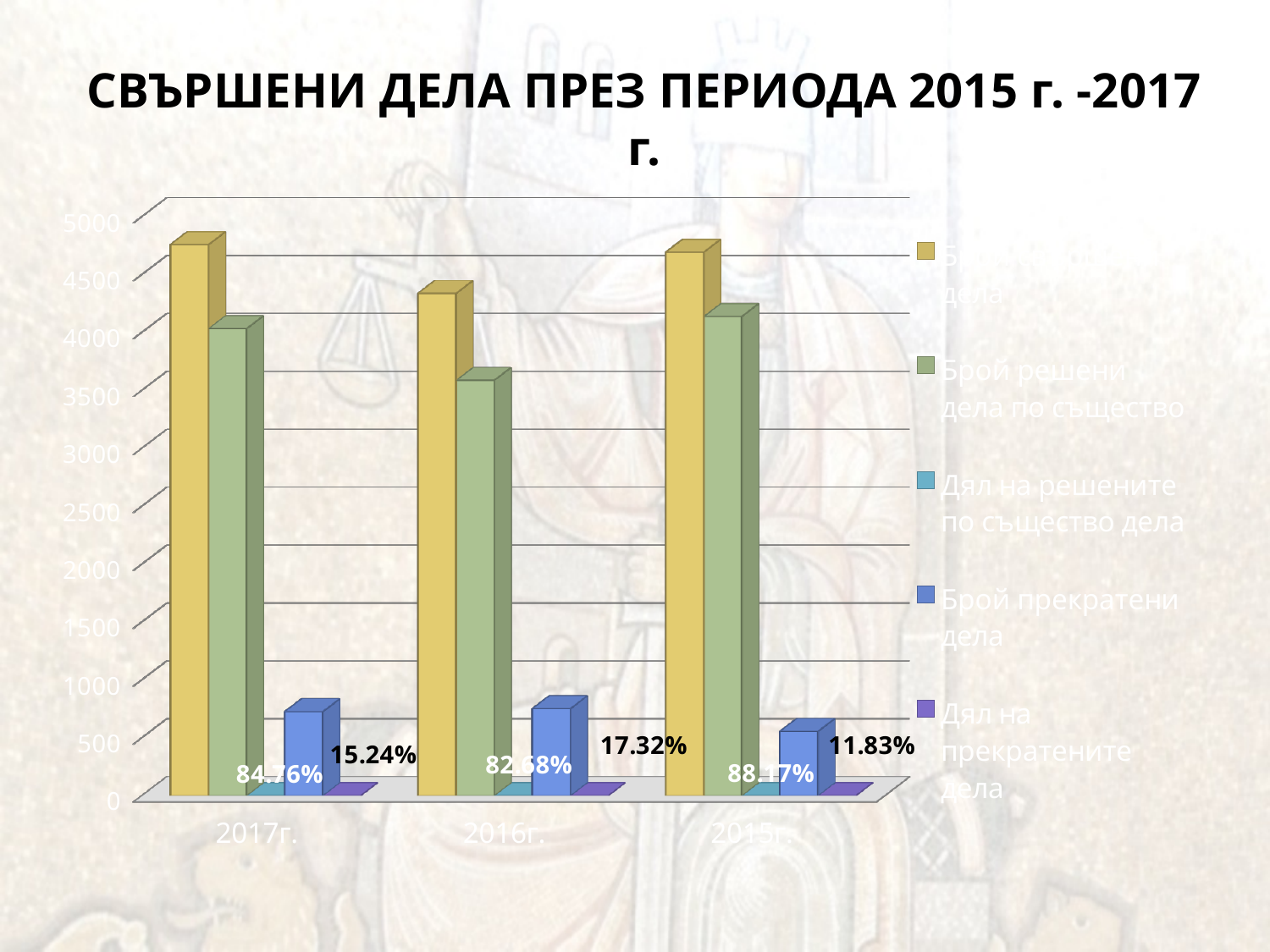
Which year has the lowest value of "Дял на прекратените дела"? 2015г. What is the value of "Дял на прекратените дела" for 2015г.? 11.83% Is the value of "Брой свършени дела" for 2017г. greater or less than 4500? greater What is the value of "Дял на решените по същество дела" for 2017г.? 84.76% What is the value of "Дял на прекратените дела" for 2016г.? 17.32% How many series does the legend list? 5 Which year has the highest value of "Дял на прекратените дела"? 2016г. What is the title of the chart? СВЪРШЕНИ ДЕЛА ПРЕЗ ПЕРИОДА 2015 г. -2017 г. What is the difference between the "Дял на прекратените дела" values for 2016г. and 2015г.? 5.49% What is the value of "Дял на прекратените дела" for 2017г.? 15.24% What kind of chart is shown on the slide? bar chart How many categories (years) are shown on the x axis? 3